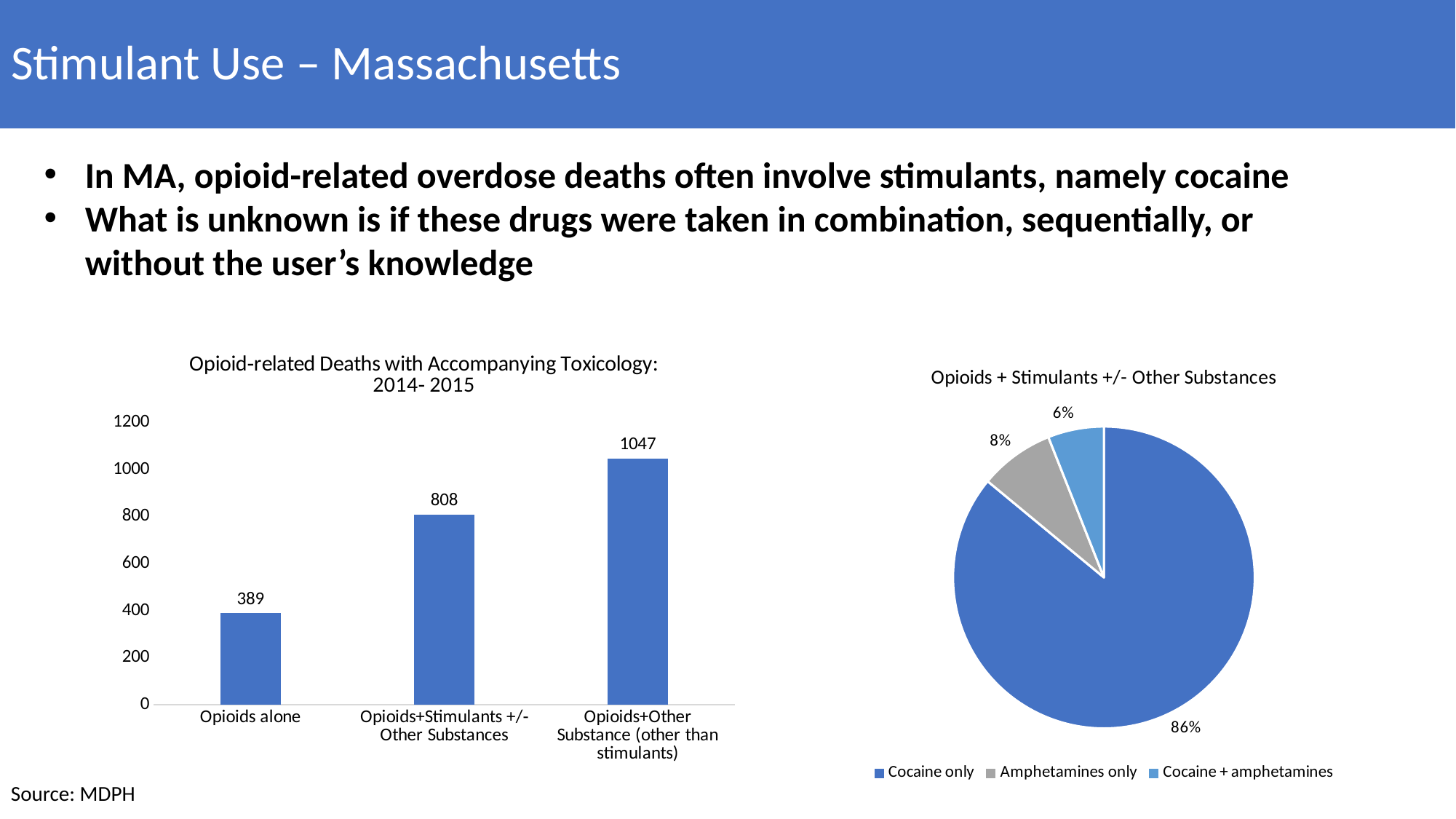
In the bar chart 'Opioid-related Deaths with Accompanying Toxicology: 2014- 2015', what is the difference between the values for Opioids+Other Substance (other than stimulants) and Opioids alone? 658 In the pie chart 'Opioids + Stimulants +/- Other Substances', what share is Amphetamines only? 8% In the bar chart 'Opioid-related Deaths with Accompanying Toxicology: 2014- 2015', which category has the highest value? Opioids+Other Substance (other than stimulants) In the bar chart 'Opioid-related Deaths with Accompanying Toxicology: 2014- 2015', which is larger: Opioids+Stimulants +/- Other Substances or Opioids alone? Opioids+Stimulants +/- Other Substances In the bar chart 'Opioid-related Deaths with Accompanying Toxicology: 2014- 2015', which category has the lowest value? Opioids alone In the pie chart 'Opioids + Stimulants +/- Other Substances', what share is Cocaine only? 86% In the bar chart 'Opioid-related Deaths with Accompanying Toxicology: 2014- 2015', how many categories are shown? 3 What kind of chart is the chart on the left of the slide? Bar chart In the bar chart 'Opioid-related Deaths with Accompanying Toxicology: 2014- 2015', what is the value for Opioids+Stimulants +/- Other Substances? 808 How many entries does the legend of the pie chart 'Opioids + Stimulants +/- Other Substances' list? 3 In the bar chart 'Opioid-related Deaths with Accompanying Toxicology: 2014- 2015', what is the value for Opioids alone? 389 In the pie chart 'Opioids + Stimulants +/- Other Substances', which slice is the smallest? Cocaine + amphetamines